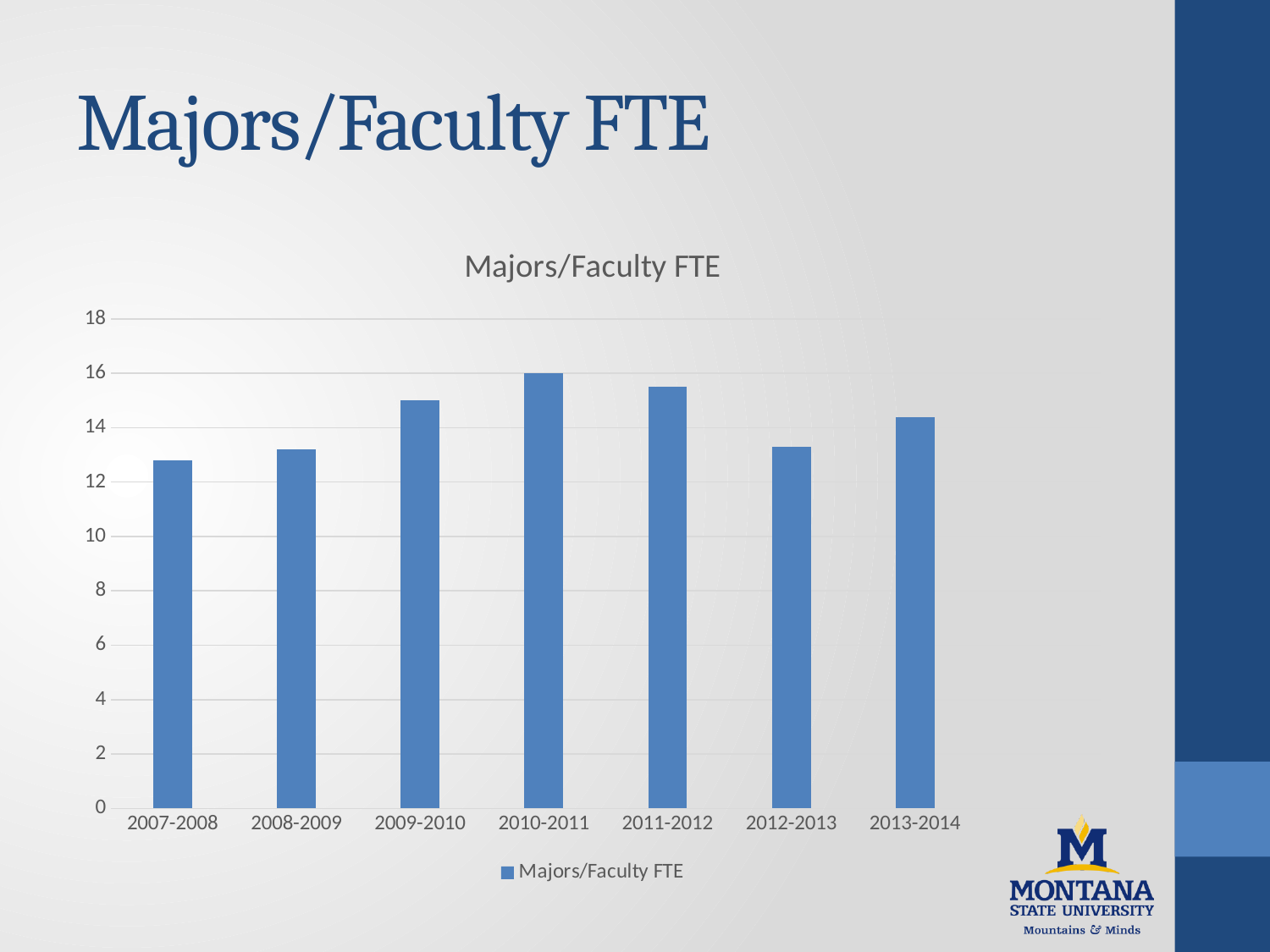
What kind of chart is shown on the slide? bar chart Which academic year has the lowest Majors/Faculty FTE? 2007-2008 How many series does the legend list? 1 Which is larger, the value for 2009-2010 or the value for 2012-2013? 2009-2010 What is the title of the chart? Majors/Faculty FTE Is the value for 2008-2009 greater or less than 14? less Which academic year has the highest Majors/Faculty FTE? 2010-2011 How many academic years are plotted on the x axis? 7 What is the Majors/Faculty FTE value for 2010-2011? 16 Do the values rise or fall from 2007-2008 to 2010-2011? rise Is the value for 2011-2012 greater or less than 16? less Is the value for 2007-2008 greater or less than 12? greater